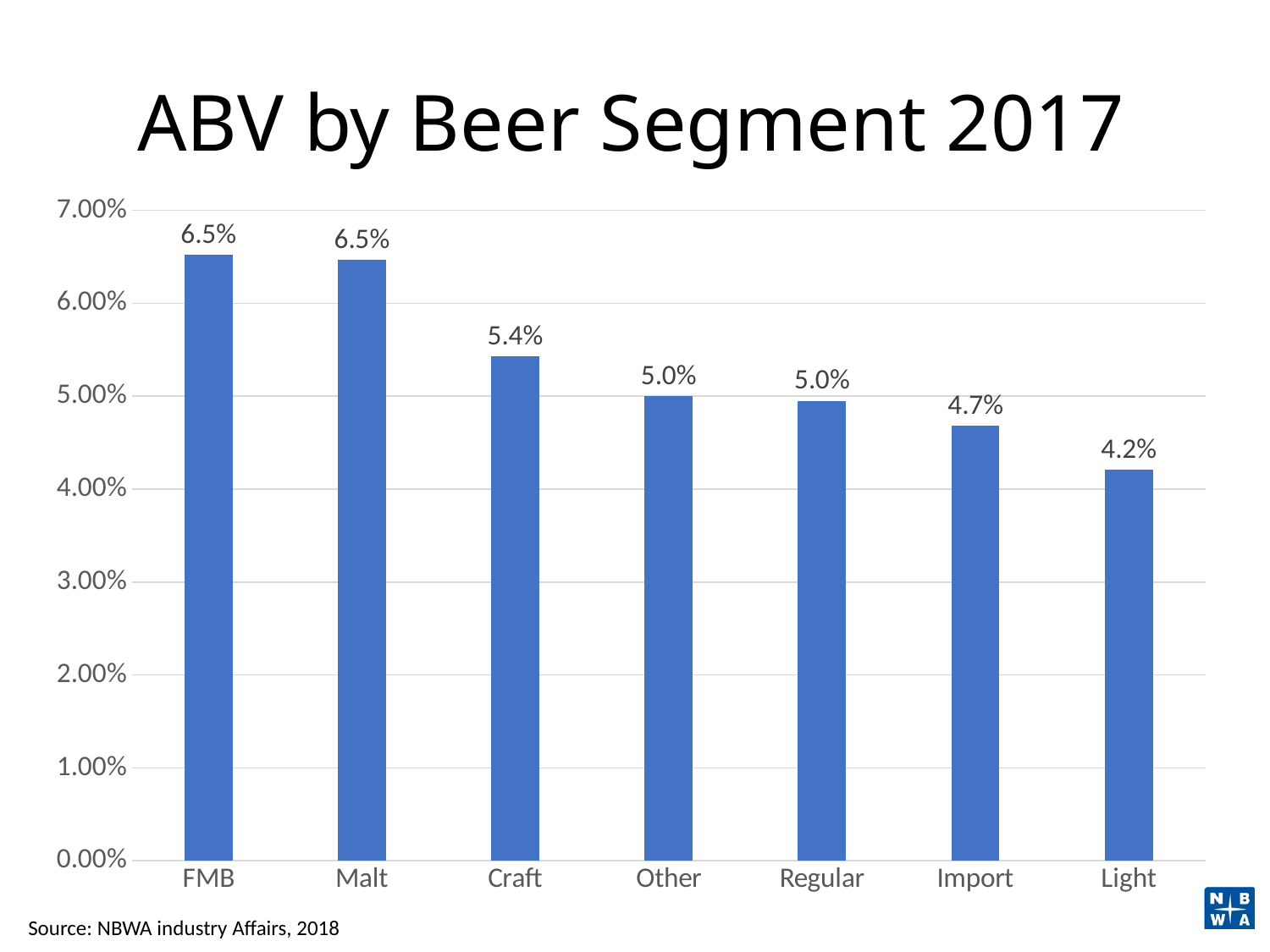
What kind of chart is shown on the slide? Bar chart What is the ABV value shown for Malt? 6.5% How many beer segments are shown on the chart? 7 Do the ABV values rise or fall moving from left to right across the segments? Fall Which has a higher ABV, Craft or Import? Craft What is the difference between the ABV for FMB and the ABV for Import? 1.8% What is the ABV value shown for Craft? 5.4% Is the value for Light greater or less than 5.00%? less What is the ABV value shown for Import? 4.7% What is the difference between the ABV for Craft and the ABV for Light? 1.2% Which beer segment has the lowest ABV? Light What is the ABV value shown for Light? 4.2%